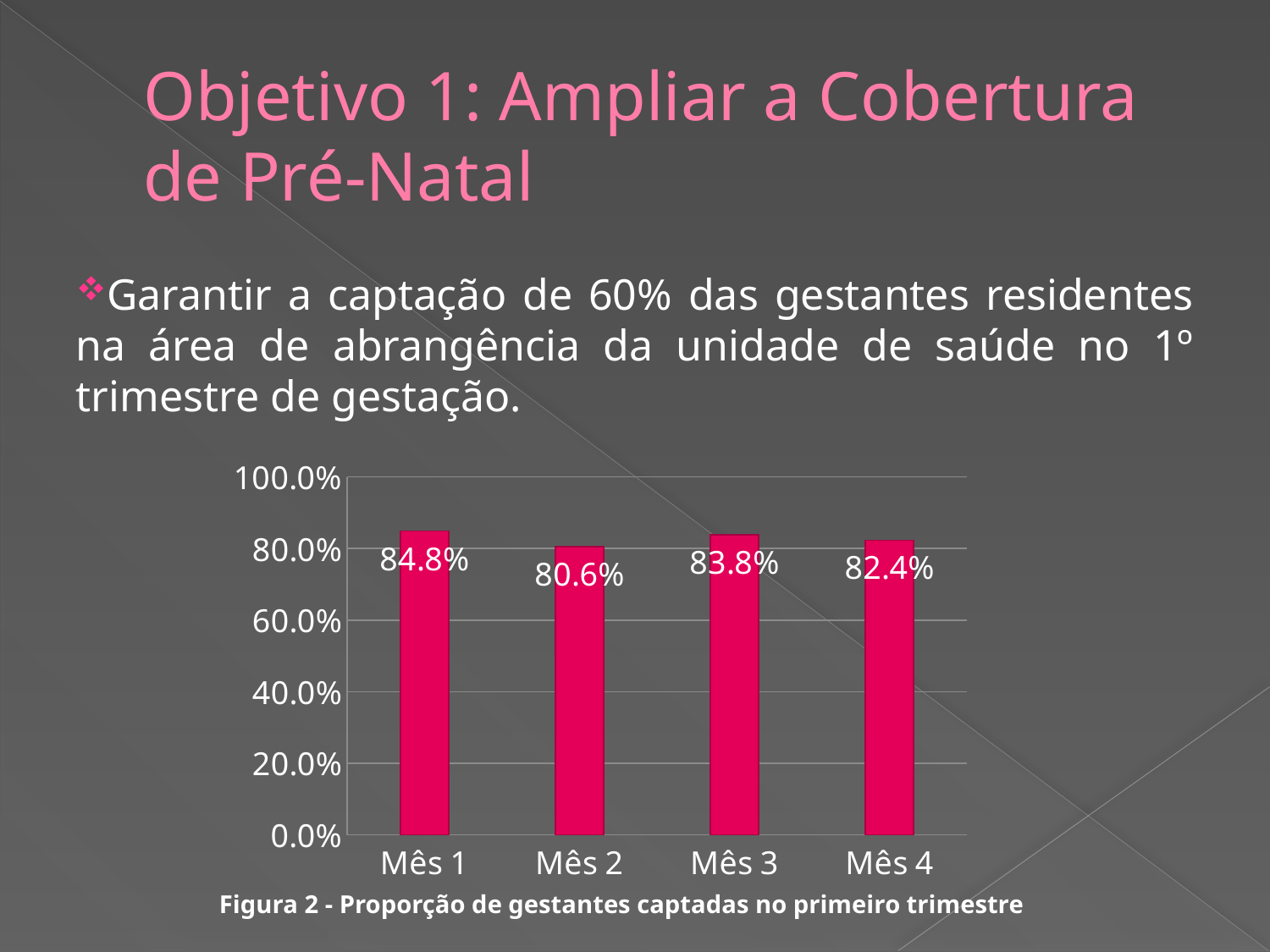
Which is larger, the value for Mês 3 or the value for Mês 4? Mês 3 Which month has the lowest value? Mês 2 What is the value for Mês 2? 80.6% What is the value for Mês 1? 84.8% What kind of chart is shown on the slide? bar chart Which month has the highest value? Mês 1 Is the value for Mês 2 greater or less than 60.0%? greater How many months are shown on the chart? 4 What is the caption of the figure below the chart? Figura 2 - Proporção de gestantes captadas no primeiro trimestre What is the difference between the values for Mês 1 and Mês 2? 4.2% What is the value for Mês 4? 82.4% What is the value for Mês 3? 83.8%